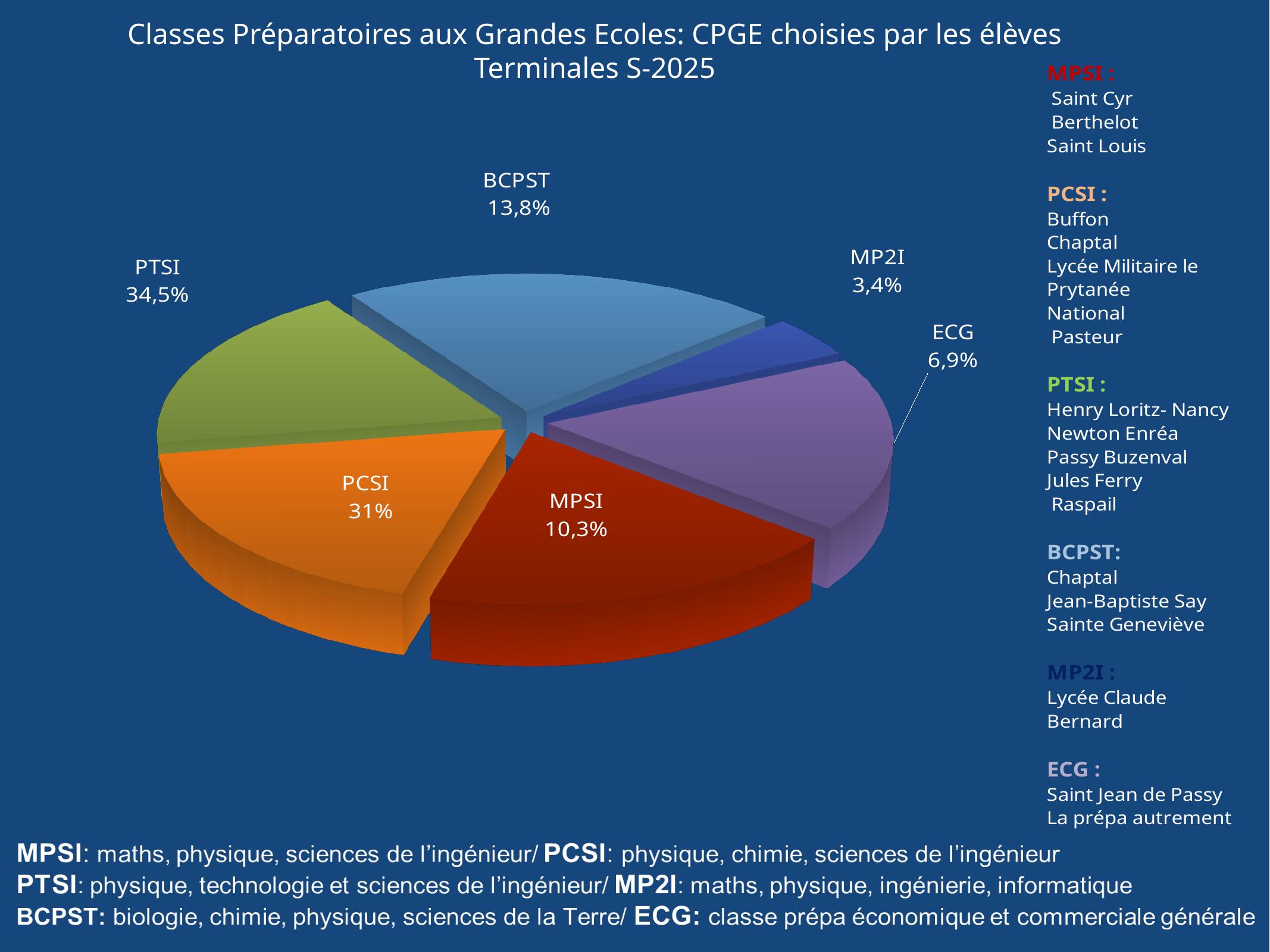
What share of the pie does MPSI represent? 10,3% What share of the pie does PCSI represent? 31% What is the difference in percentage points between PTSI and PCSI? 3,5 How many CPGE categories are shown in the pie chart? 6 What share of the pie does ECG represent? 6,9% Which CPGE has the largest share of the pie? PTSI What share of the pie does PTSI represent? 34,5% What kind of chart is shown on the slide? Pie chart What share of the pie does BCPST represent? 13,8% What share of the pie does MP2I represent? 3,4% Which CPGE has the smallest share of the pie? MP2I Which has a larger share, BCPST or MPSI? BCPST